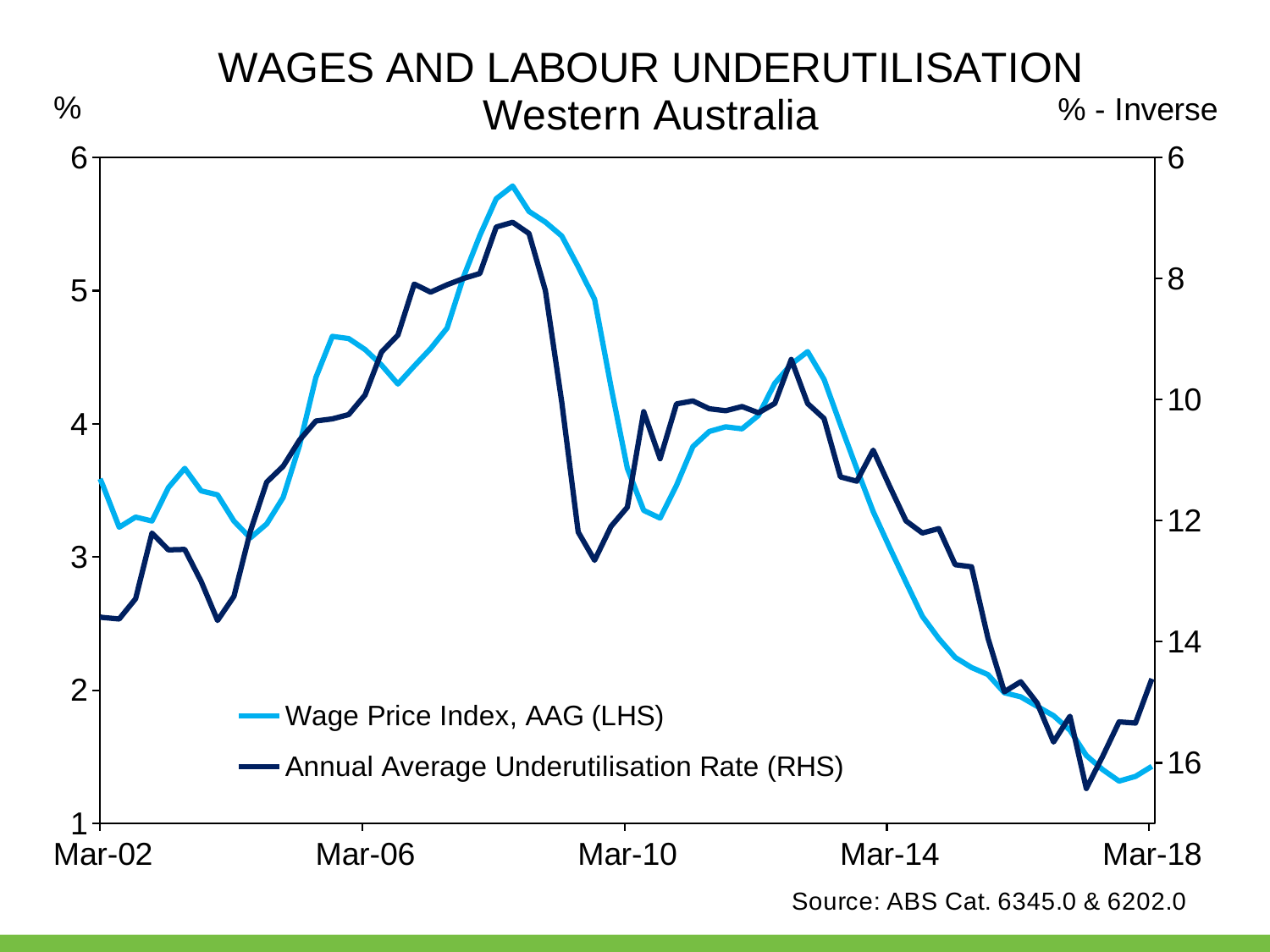
Is the Annual Average Underutilisation Rate at Mar-18 greater or less than 16? less Is the Wage Price Index, AAG value at Mar-02 greater or less than 3? greater Is the Annual Average Underutilisation Rate at Mar-18 greater or less than 12? greater Which is larger for the Wage Price Index, AAG: the value at Mar-02 or the value at Mar-18? Mar-02 What kind of chart is shown on the slide? Line chart Which series is plotted on the right-hand (inverse) axis? Annual Average Underutilisation Rate (RHS) What is the title of the chart? WAGES AND LABOUR UNDERUTILISATION Western Australia Does the Wage Price Index, AAG rise or fall between Mar-02 and Mar-06? rise How many series does the legend list? 2 Does the Wage Price Index, AAG rise or fall between Mar-14 and Mar-18? fall